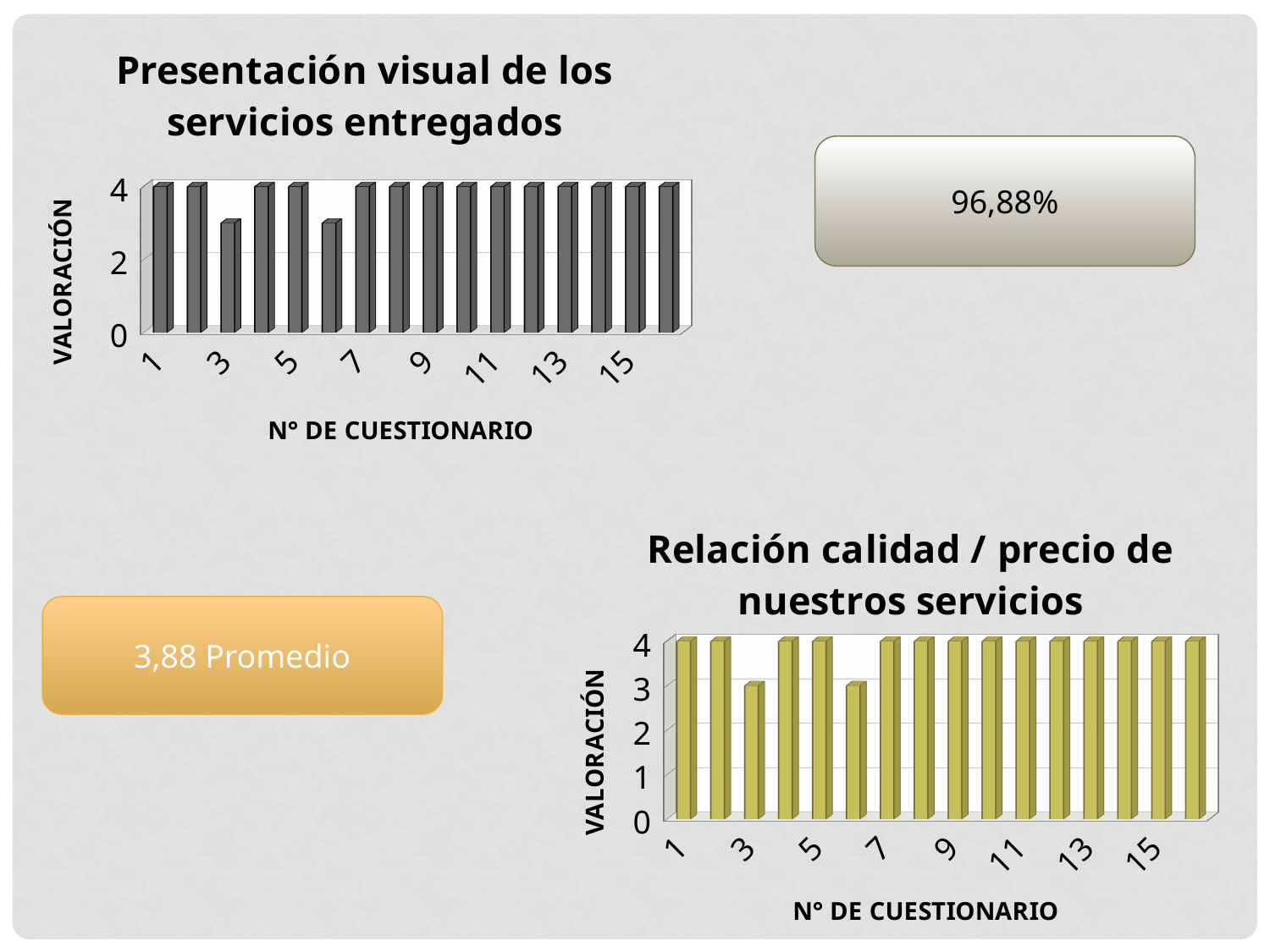
In the 'Relación calidad / precio de nuestros servicios' chart, what is the valoración for questionnaire 3? 3 What is the y-axis title of the 'Relación calidad / precio de nuestros servicios' chart? VALORACIÓN How many bars are plotted in the 'Relación calidad / precio de nuestros servicios' chart? 16 In the 'Relación calidad / precio de nuestros servicios' chart, what is the valoración for questionnaire 1? 4 In the 'Presentación visual de los servicios entregados' chart, is the value for questionnaire 3 greater or less than 2? greater In the 'Relación calidad / precio de nuestros servicios' chart, which questionnaire numbers have the lowest valoración? 3 and 6 In the 'Presentación visual de los servicios entregados' chart, what is the valoración for questionnaire 1? 4 What is the x-axis title of the 'Presentación visual de los servicios entregados' chart? N° DE CUESTIONARIO What kind of chart is the 'Presentación visual de los servicios entregados' chart? bar chart In the 'Presentación visual de los servicios entregados' chart, which has the higher valoración, questionnaire 1 or questionnaire 3? questionnaire 1 In the 'Relación calidad / precio de nuestros servicios' chart, what is the difference between the valoración for questionnaire 1 and questionnaire 3? 1 How many bars are plotted in the 'Presentación visual de los servicios entregados' chart? 16